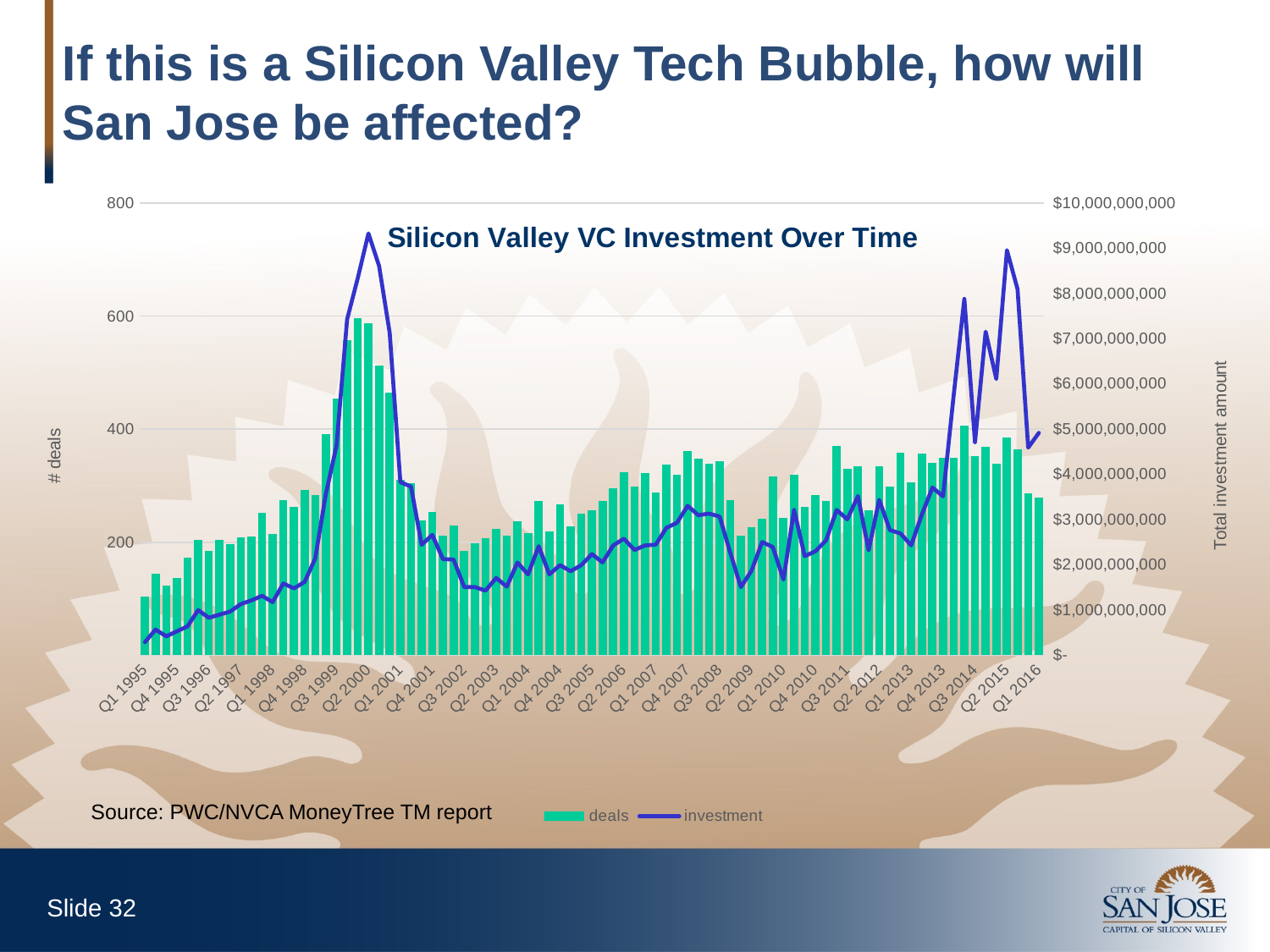
What is the title of the chart? Silicon Valley VC Investment Over Time What does the left vertical axis of the chart measure? # deals Is the investment amount in Q1 2016 greater or less than $4,000,000,000? greater Is the number of deals in Q1 1995 greater or less than 200? less Is the investment amount in Q1 1995 greater or less than $1,000,000,000? less How many series does the chart legend list? 2 Did the number of deals rise or fall from Q1 1995 to Q2 2000? rise What kind of chart is shown on the slide? Combined bar and line chart Did the investment amount rise or fall from Q2 2000 to Q3 2002? fall Which quarter had more deals, Q1 1995 or Q1 2016? Q1 2016